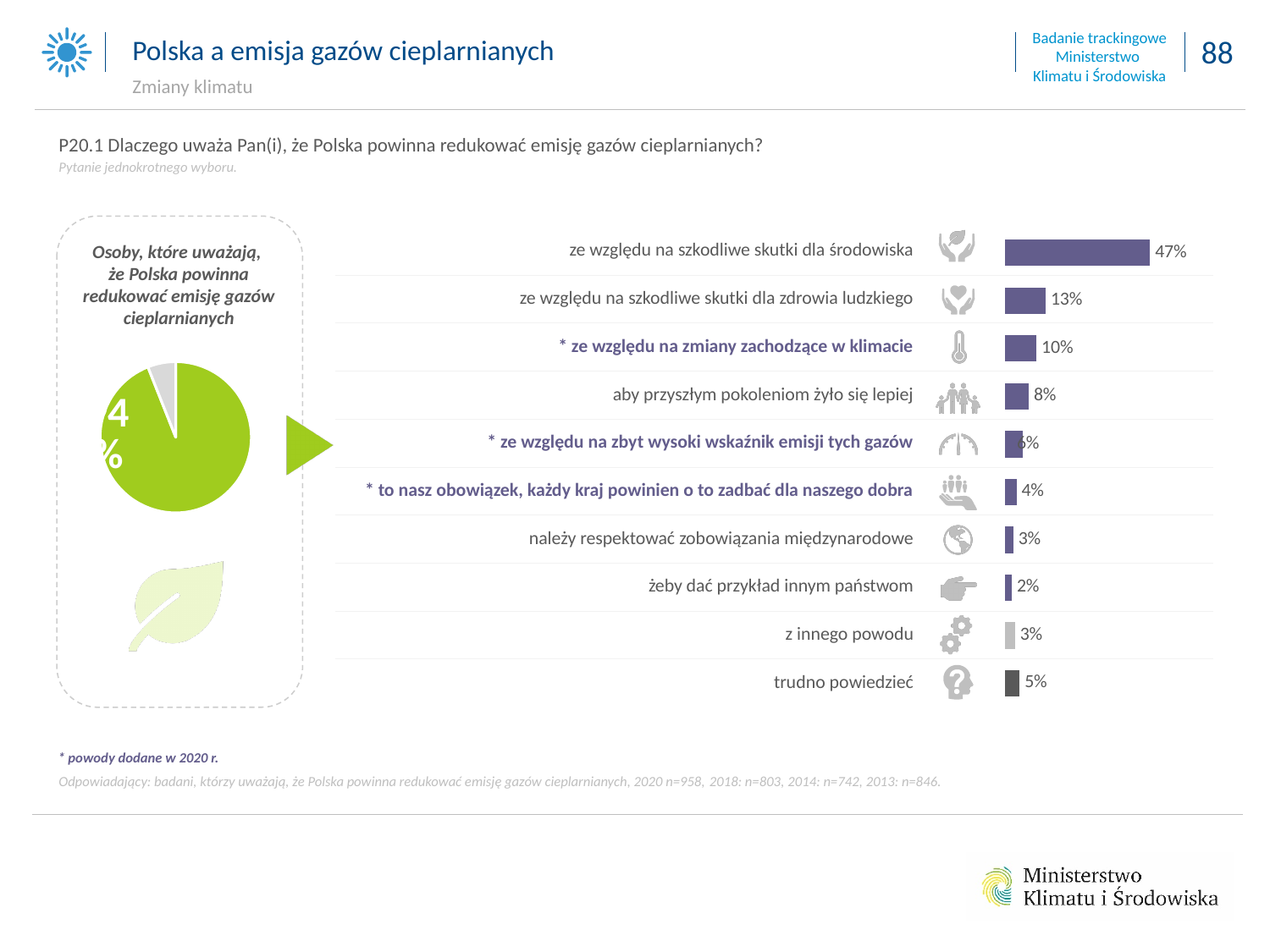
In the bar chart, what percentage is shown for "żeby dać przykład innym państwom"? 2% In the bar chart, what percentage is shown for "trudno powiedzieć"? 5% In the bar chart, what percentage is shown for "aby przyszłym pokoleniom żyło się lepiej"? 8% In the bar chart, which reason has the highest percentage? ze względu na szkodliwe skutki dla środowiska In the bar chart, what percentage is shown for "ze względu na szkodliwe skutki dla zdrowia ludzkiego"? 13% In the bar chart, which reason has the lowest percentage? żeby dać przykład innym państwom In the bar chart, what percentage is shown for "ze względu na zmiany zachodzące w klimacie"? 10% In the bar chart, what percentage is shown for "ze względu na szkodliwe skutki dla środowiska"? 47% What type of chart is used to show the reasons on the right side of the slide? Bar chart In the bar chart, which is larger: the value for "ze względu na zmiany zachodzące w klimacie" or for "aby przyszłym pokoleniom żyło się lepiej"? ze względu na zmiany zachodzące w klimacie In the bar chart, what is the difference between the percentages for "ze względu na szkodliwe skutki dla środowiska" and "ze względu na szkodliwe skutki dla zdrowia ludzkiego"? 34 percentage points How many reasons (categories) are listed in the bar chart? 10